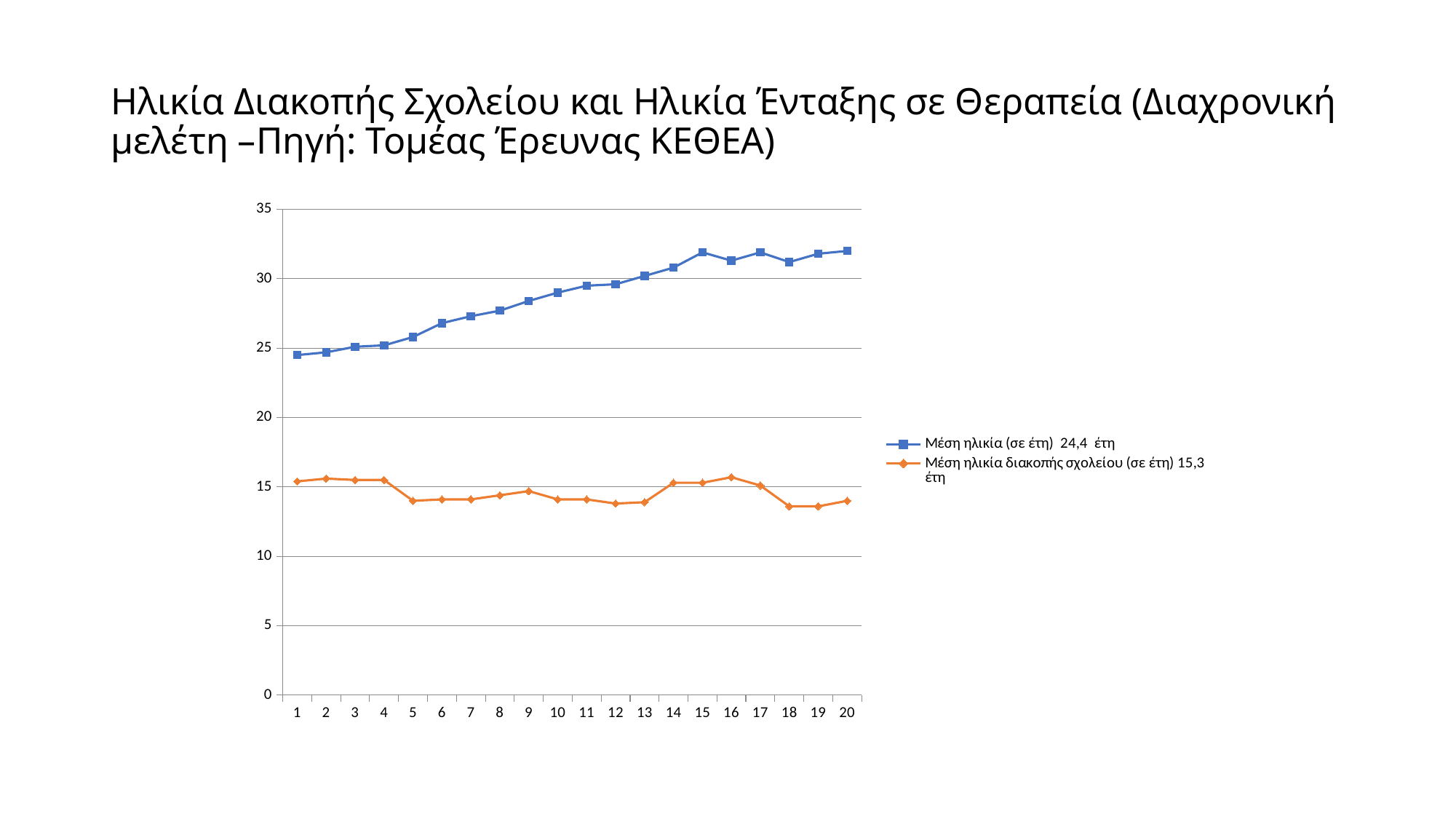
Is the value of 'Μέση ηλικία (σε έτη)' at point 1 greater or less than 25? less What kind of chart is shown on the slide? line chart Is the value of 'Μέση ηλικία διακοπής σχολείου (σε έτη)' at point 5 greater or less than 15? less Is the value of 'Μέση ηλικία (σε έτη)' at point 10 greater or less than 30? less How many points are plotted along the x axis for each series? 20 Does the series 'Μέση ηλικία (σε έτη)' generally rise or fall from point 1 to point 20? rise Which series is drawn in orange? Μέση ηλικία διακοπής σχολείου (σε έτη) 15,3 έτη How many series does the legend list? 2 At point 10, which series has the larger value: 'Μέση ηλικία (σε έτη)' or 'Μέση ηλικία διακοπής σχολείου (σε έτη)'? Μέση ηλικία (σε έτη) What is the highest value shown on the vertical axis? 35